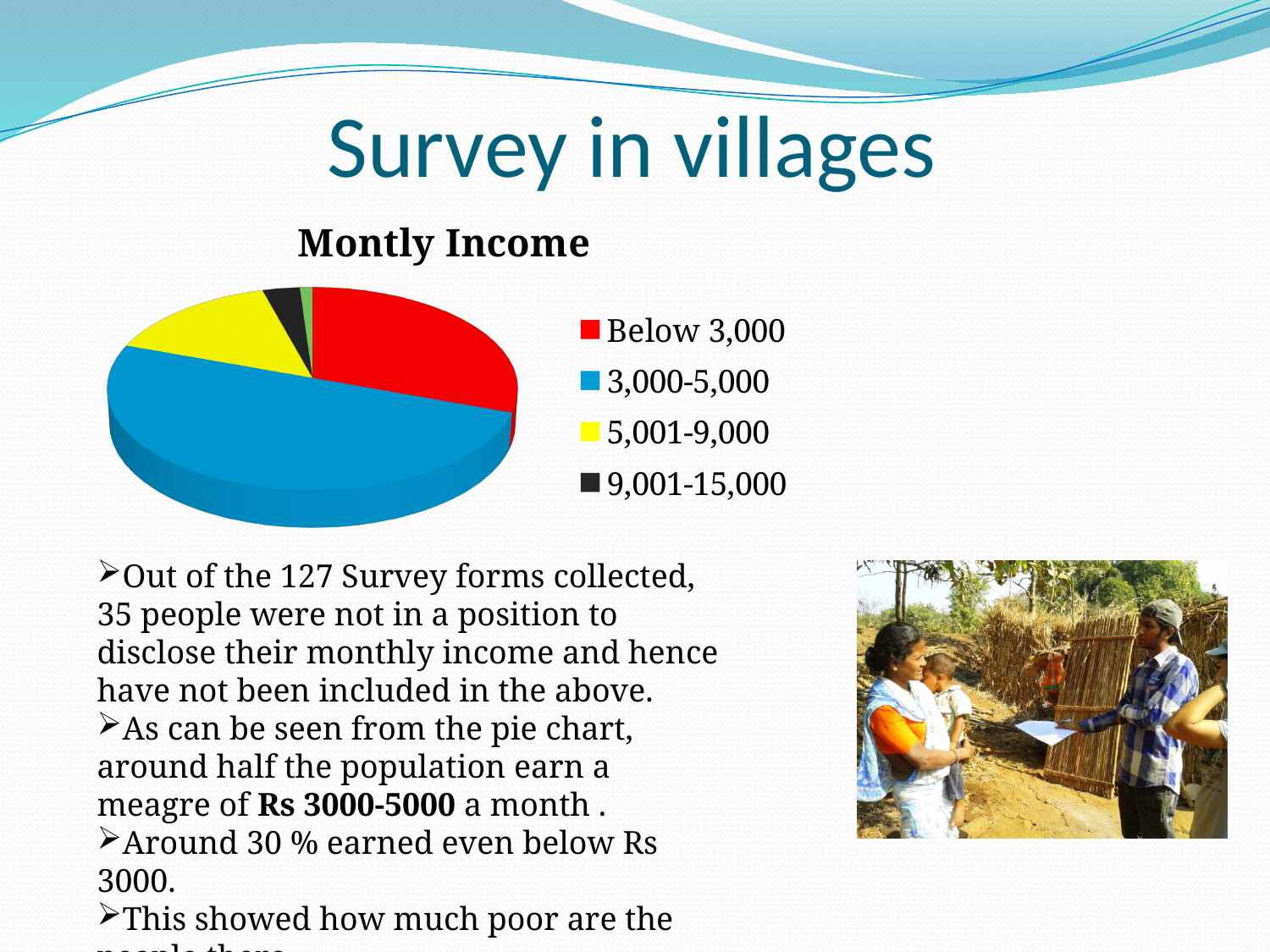
How many income categories does the chart's legend list? 4 Which income category has the largest slice of the pie? 3,000-5,000 Which slice is larger: 5,001-9,000 or 9,001-15,000? 5,001-9,000 Which slice is larger: Below 3,000 or 5,001-9,000? Below 3,000 What kind of chart is shown on the slide? pie chart Which slice is larger: 3,000-5,000 or Below 3,000? 3,000-5,000 What is the title of the chart? Montly Income Which colour represents the Below 3,000 category in the chart? red Of the categories listed in the legend, which has the smallest slice? 9,001-15,000